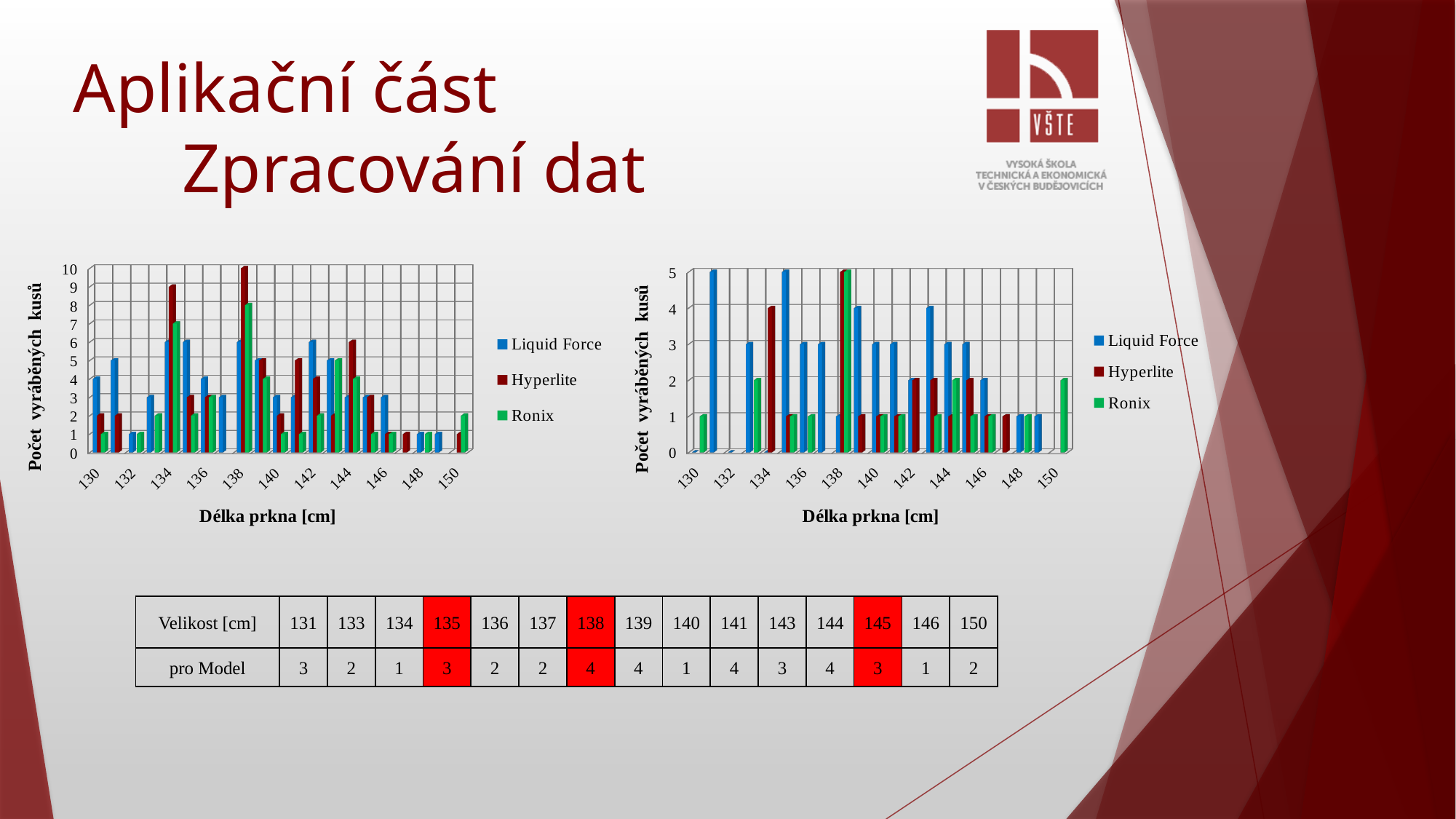
What kind of chart is the left chart on the slide? bar chart In the left chart, what value does the tallest bar reach? 10 How many series does the legend of the left chart list? 3 In the left chart, at 138 cm, which is larger: Hyperlite or Ronix? Hyperlite In the right chart, is the value for Hyperlite at 134 cm greater or less than 3? greater In the right chart, is the value for Liquid Force at 131 cm greater or less than 3? greater What is the x-axis title of the left chart? Délka prkna [cm] In the left chart, is the value for Hyperlite at 134 cm greater or less than 8? greater In the right chart, what is the highest value shown on the y axis? 5 In the left chart, which series has the tallest bar? Hyperlite In the right chart, what is the value for Ronix at 150 cm? 2 What are the legend entries of the right chart? Liquid Force, Hyperlite, Ronix